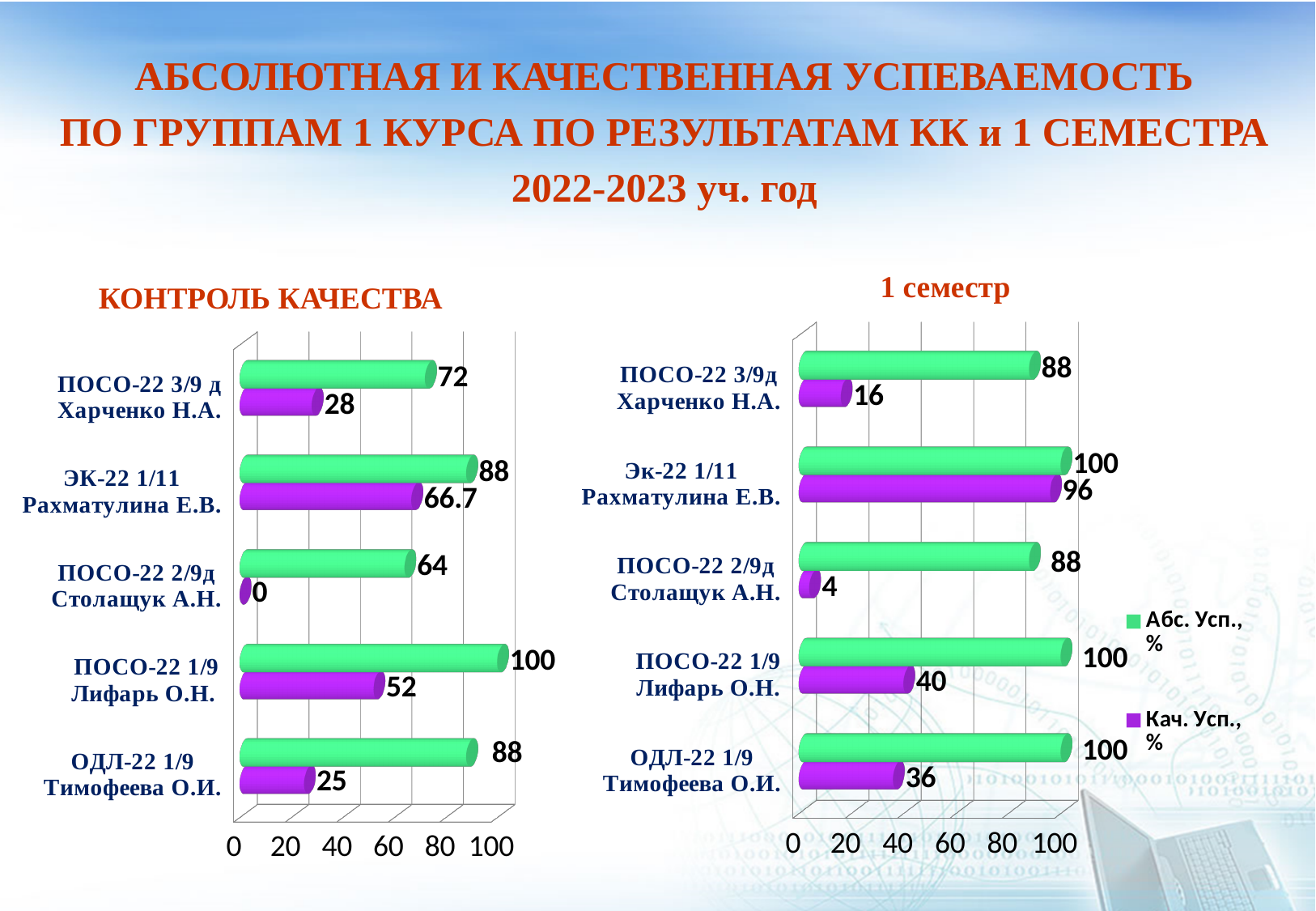
How many groups are shown in the 'КОНТРОЛЬ КАЧЕСТВА' chart? 5 What type of chart is the '1 семестр' chart? Bar chart In the '1 семестр' chart, which is larger: the Кач. Усп., % value for ОДЛ-22 1/9 Тимофеева О.И. or for ПОСО-22 3/9д Харченко Н.А.? ОДЛ-22 1/9 Тимофеева О.И. How many series does the legend of the '1 семестр' chart list? 2 In the 'КОНТРОЛЬ КАЧЕСТВА' chart, which group has the lowest purple bar value? ПОСО-22 2/9д Столащук А.Н. In the '1 семестр' chart, which group has the highest Кач. Усп., % value? Эк-22 1/11 Рахматулина Е.В. In the '1 семестр' chart, what is the Кач. Усп., % value for Эк-22 1/11 Рахматулина Е.В.? 96 In the 'КОНТРОЛЬ КАЧЕСТВА' chart, what is the value of the green bar for ЭК-22 1/11 Рахматулина Е.В.? 88 In the 'КОНТРОЛЬ КАЧЕСТВА' chart, what is the value of the purple bar for ПОСО-22 1/9 Лифарь О.Н.? 52 In the '1 семестр' chart, what is the Абс. Усп., % value for ПОСО-22 3/9д Харченко Н.А.? 88 In the 'КОНТРОЛЬ КАЧЕСТВА' chart, what is the difference between the green and purple bar values for ПОСО-22 3/9 д Харченко Н.А.? 44 In the '1 семестр' chart, what is the difference between the Абс. Усп., % and Кач. Усп., % values for ПОСО-22 1/9 Лифарь О.Н.? 60